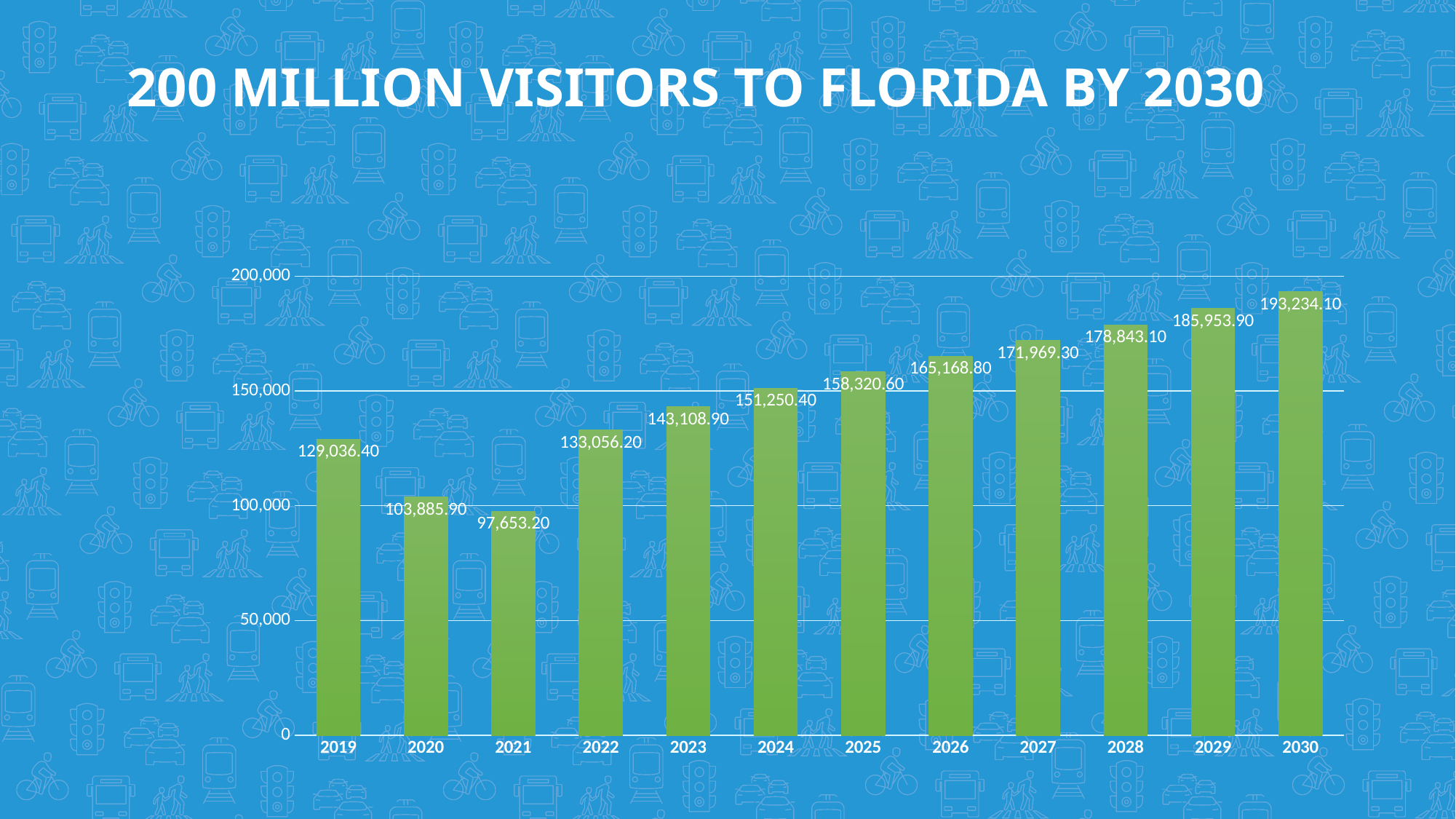
What is the value for 2025? 158,320.60 What is the value for 2019? 129,036.40 Which year has the highest value? 2030 How many years are shown on the x axis? 12 What is the difference between the values for 2020 and 2021? 6,232.70 Which is larger, the value for 2020 or the value for 2022? 2022 Is the value for 2021 greater or less than 100,000? less What is the difference between the values for 2030 and 2019? 64,197.70 What is the value for 2030? 193,234.10 What is the title of the slide? 200 MILLION VISITORS TO FLORIDA BY 2030 Which year has the lowest value? 2021 What kind of chart is shown on the slide? bar chart